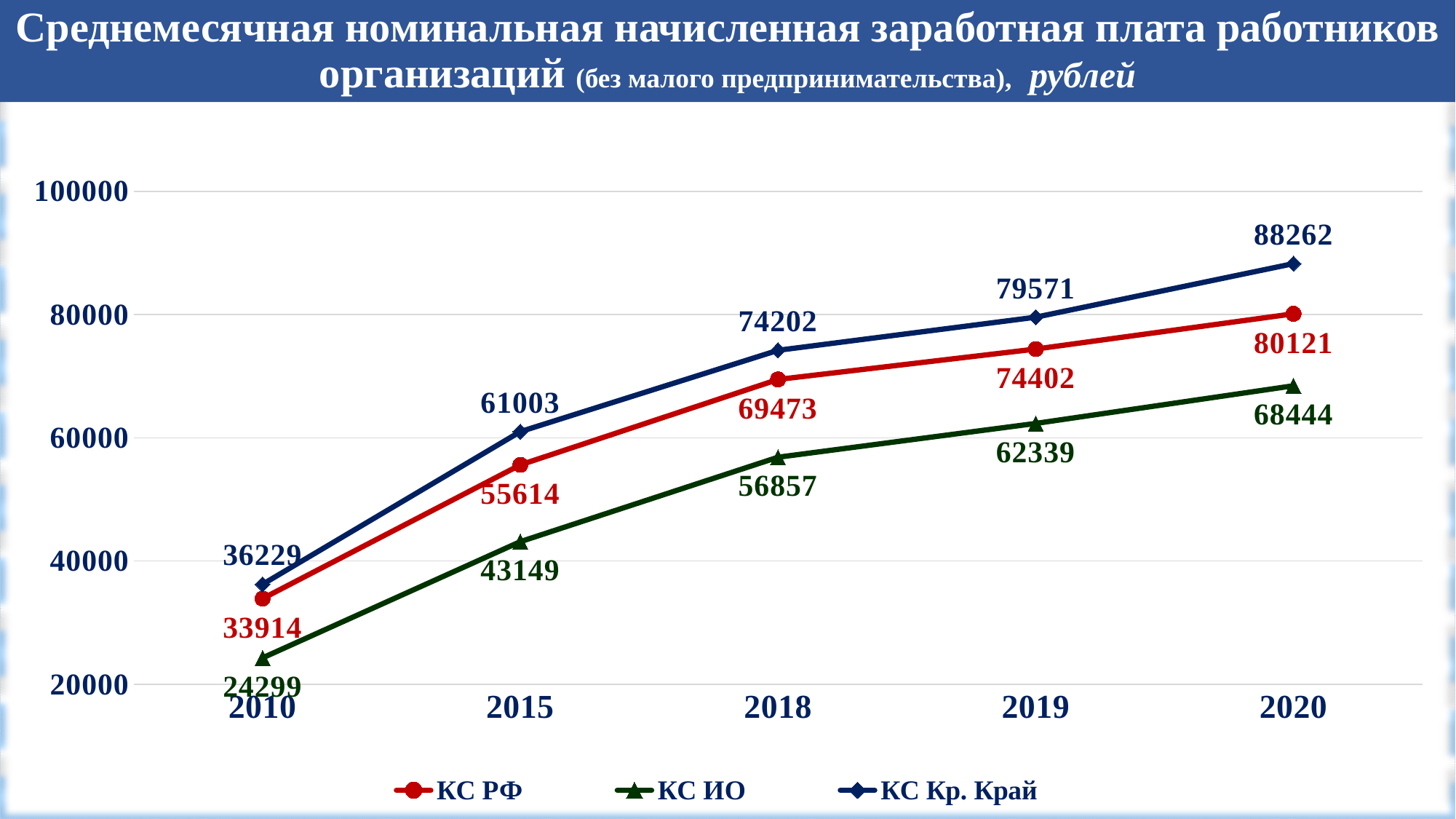
What is the value for КС ИО in 2010? 24299 How many years are shown on the x axis? 5 How many series does the legend list? 3 Which is larger in 2018: КС РФ or КС ИО? КС РФ What is the value for КС Кр. Край in 2020? 88262 What is the difference between КС Кр. Край and КС РФ in 2020? 8141 Which series has the lowest value in 2020? КС ИО What is the value for КС РФ in 2018? 69473 What kind of chart is this? line chart Do the values for КС ИО rise or fall from 2010 to 2020? rise Which series has the highest value in 2015? КС Кр. Край What is the value for КС ИО in 2019? 62339